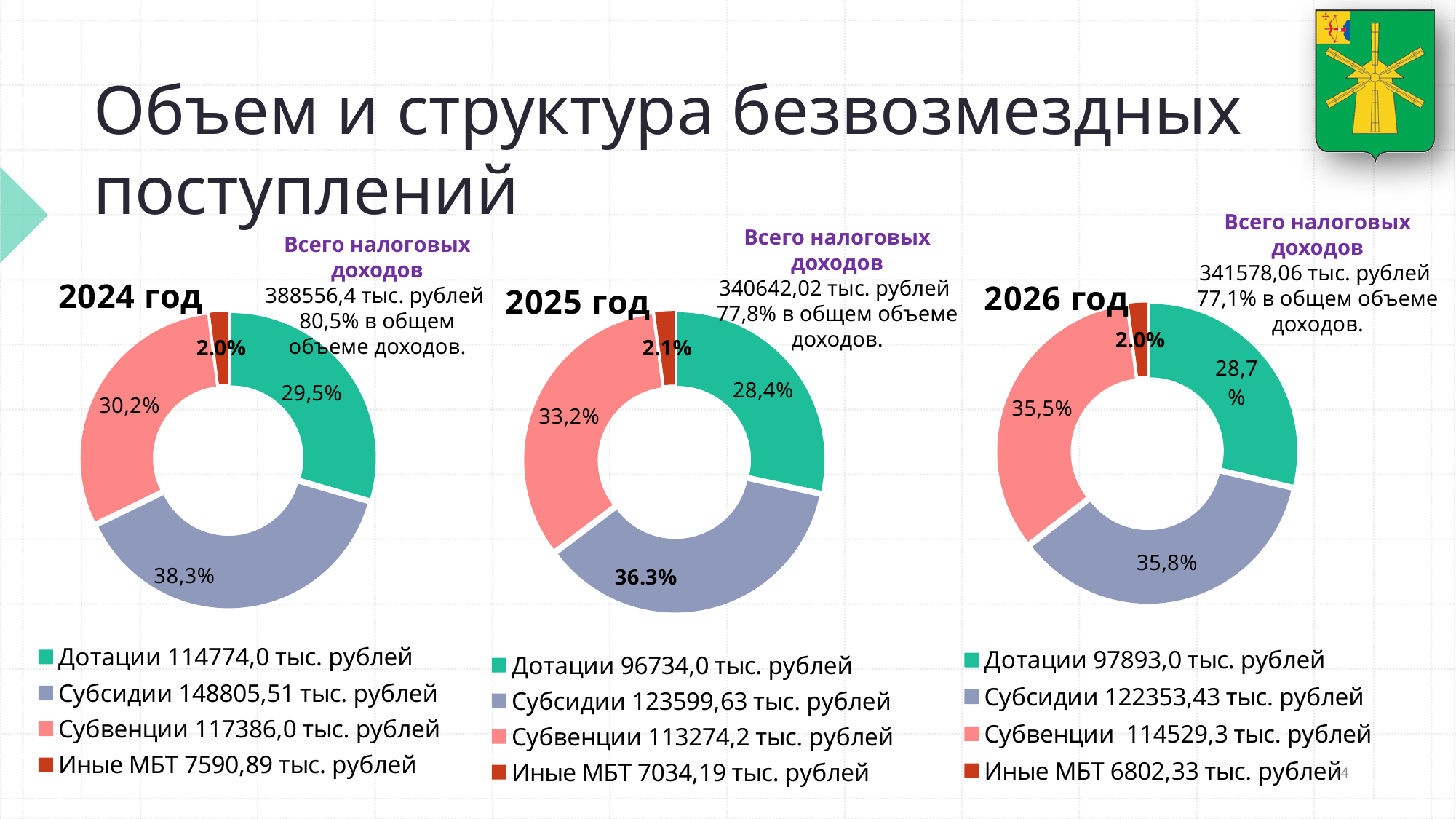
In the 2024 год chart, which category has the largest share? Субсидии In the 2024 год chart, what is the difference between the Субсидии share and the Дотации share? 8,8% In the 2026 год chart, what share does the Дотации slice have? 28,7% According to the legend of the 2026 год chart, what is the amount for Иные МБТ? 6802,33 тыс. рублей How many slices does the 2026 год chart have? 4 In the 2025 год chart, which category has the smallest share? Иные МБТ In the 2025 год chart, what share does the Субвенции slice have? 33,2% What type of chart is used for 2024 год? Doughnut (pie) chart How many entries does the legend of the 2024 год chart list? 4 In the 2025 год chart, which is larger: the Субвенции share or the Дотации share? Субвенции In the 2024 год chart, what share does the Субсидии slice have? 38,3% According to the legend of the 2025 год chart, what is the amount for Субсидии? 123599,63 тыс. рублей